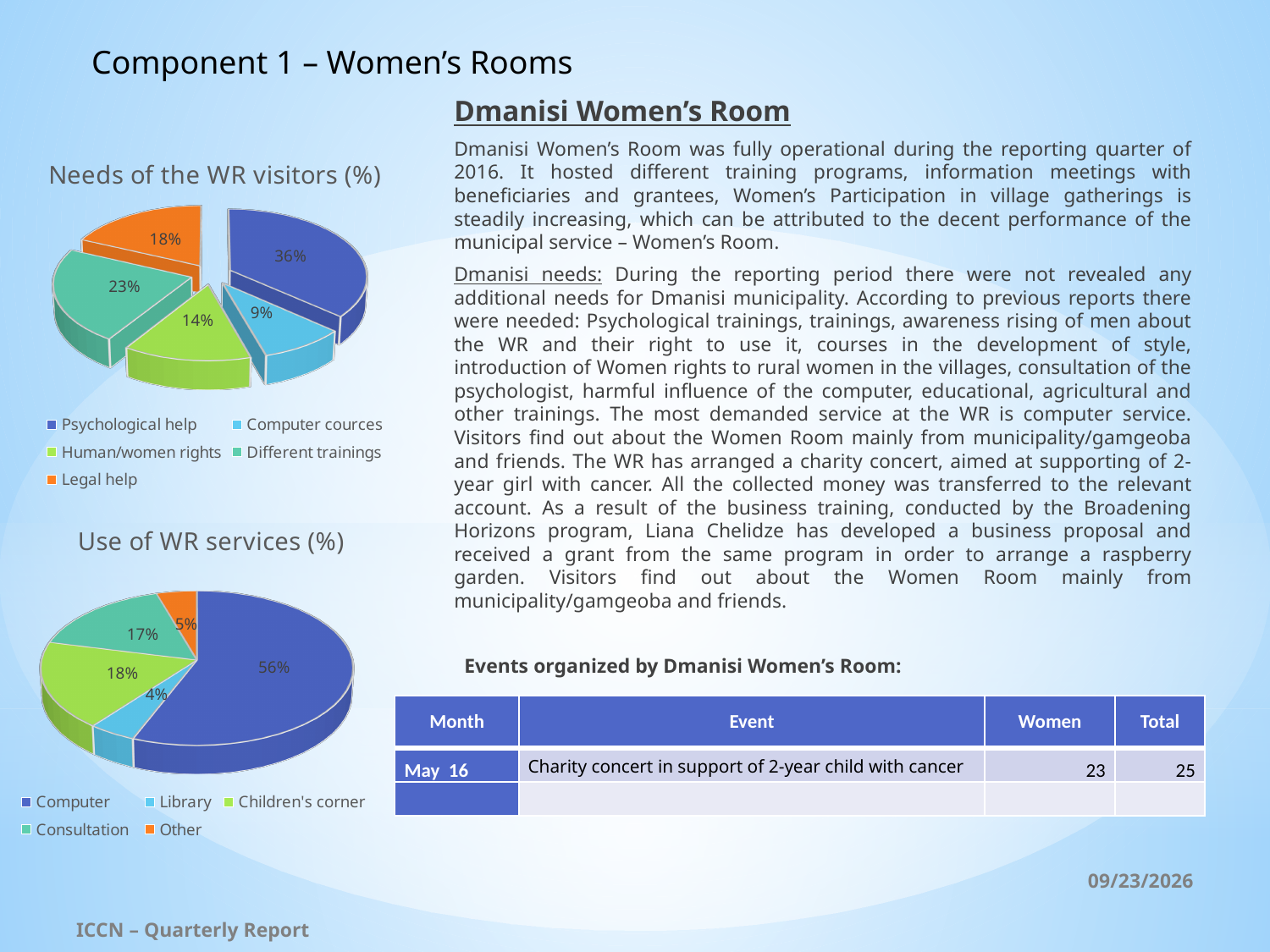
In the 'Needs of the WR visitors (%)' chart, what share is Different trainings? 23% What type of chart is 'Use of WR services (%)'? Pie chart In the 'Use of WR services (%)' chart, which is larger, Children's corner or Consultation? Children's corner In the 'Use of WR services (%)' chart, what share is Computer? 56% In the 'Needs of the WR visitors (%)' chart, what is the difference between Legal help and Human/women rights? 4% How many categories does the legend of the 'Needs of the WR visitors (%)' chart list? 5 In the 'Needs of the WR visitors (%)' chart, what share is Psychological help? 36% In the 'Use of WR services (%)' chart, what colour is the Computer slice? Dark blue In the 'Use of WR services (%)' chart, what share is Library? 4% In the 'Use of WR services (%)' chart, what is the difference between Computer and Other? 51% In the 'Needs of the WR visitors (%)' chart, which category has the largest share? Psychological help In the 'Needs of the WR visitors (%)' chart, which category has the smallest share? Computer cources